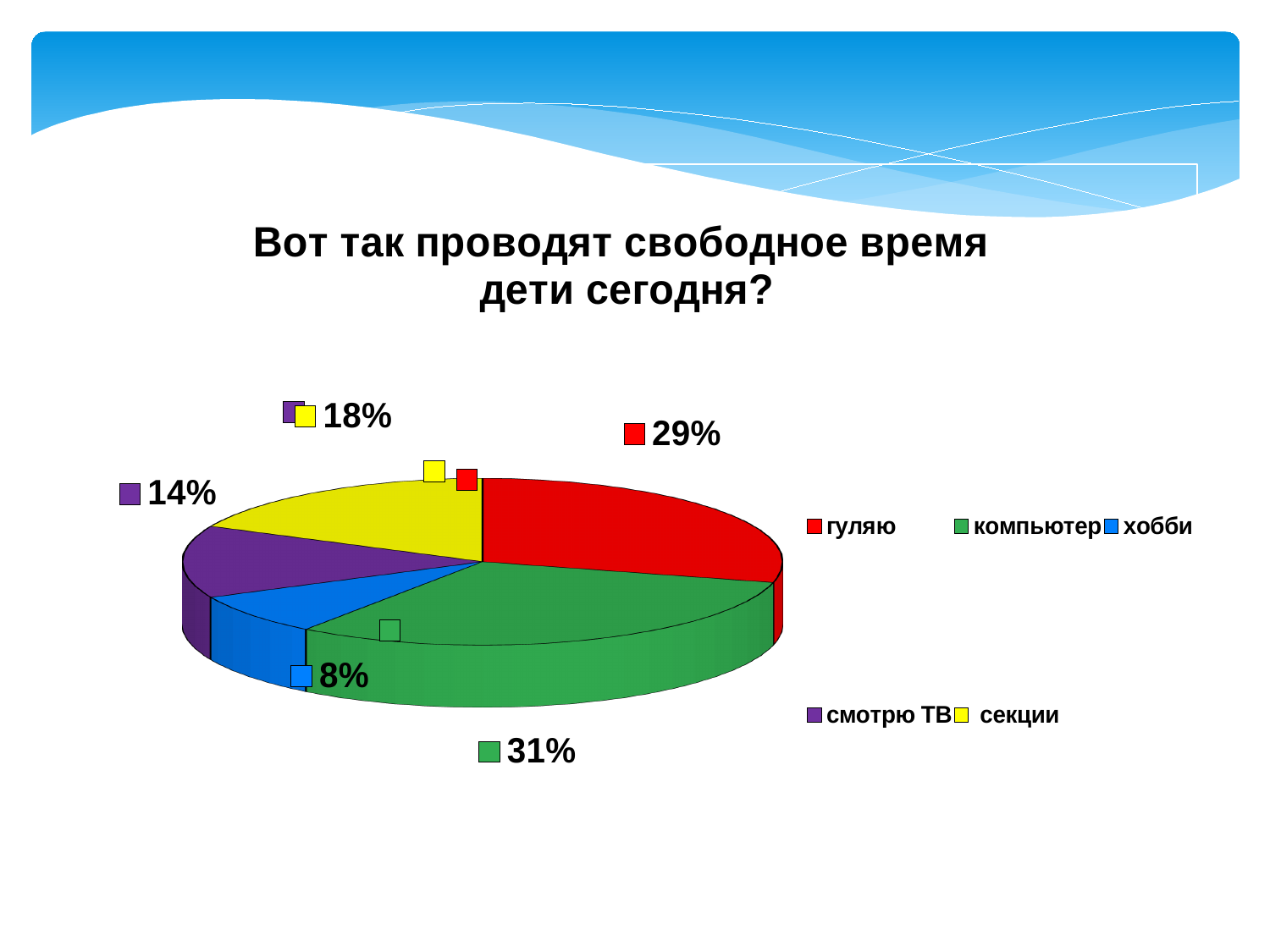
What percentage of the pie is labelled for "секции"? 18% What percentage of the pie is labelled for "гуляю"? 29% What percentage of the pie is labelled for "хобби"? 8% Which category has the smallest share of the pie? хобби Which is larger, the share for "секции" or the share for "смотрю ТВ"? секции What percentage of the pie is labelled for "смотрю ТВ"? 14% How many categories does the legend list? 5 What kind of chart is shown on the slide? pie chart What is the difference in percentage points between "компьютер" and "гуляю"? 2 Which category has the largest share of the pie? компьютер What percentage of the pie is labelled for "компьютер"? 31% What colour is the slice for "смотрю ТВ"? purple